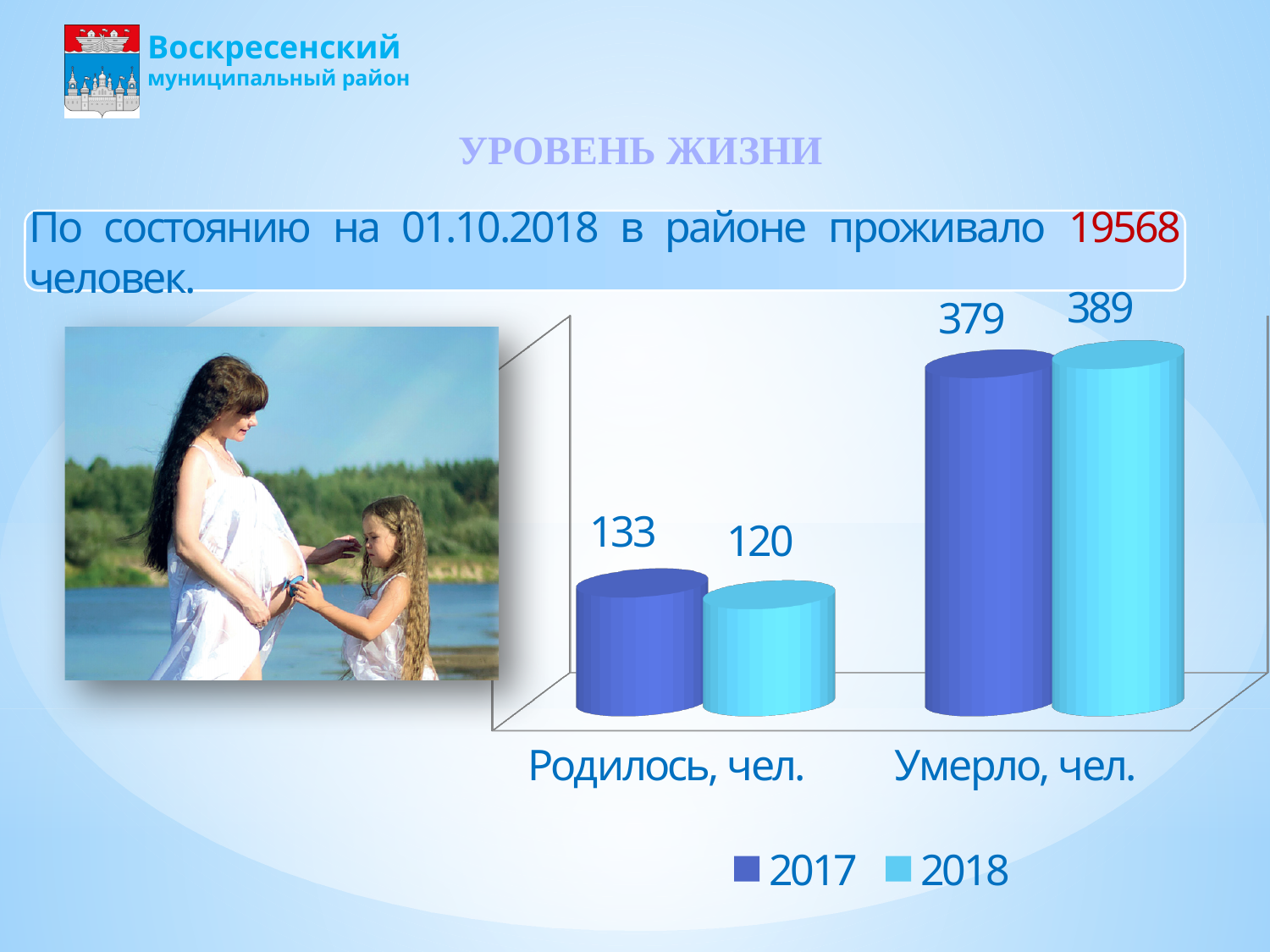
How many categories are shown on the x axis of the chart? 2 Which is larger for "Умерло, чел.": the 2017 value or the 2018 value? 2018 What is the value for "Родилось, чел." in 2018? 120 What kind of chart is shown on the slide? bar chart What is the value for "Умерло, чел." in 2018? 389 Which category has the lowest value in the 2017 series? Родилось, чел. What is the difference between the 2018 and 2017 values for "Умерло, чел."? 10 What is the value for "Умерло, чел." in 2017? 379 What is the value for "Родилось, чел." in 2017? 133 Which category has the highest value in the 2018 series? Умерло, чел. How many series does the legend list? 2 What is the difference between the 2017 and 2018 values for "Родилось, чел."? 13